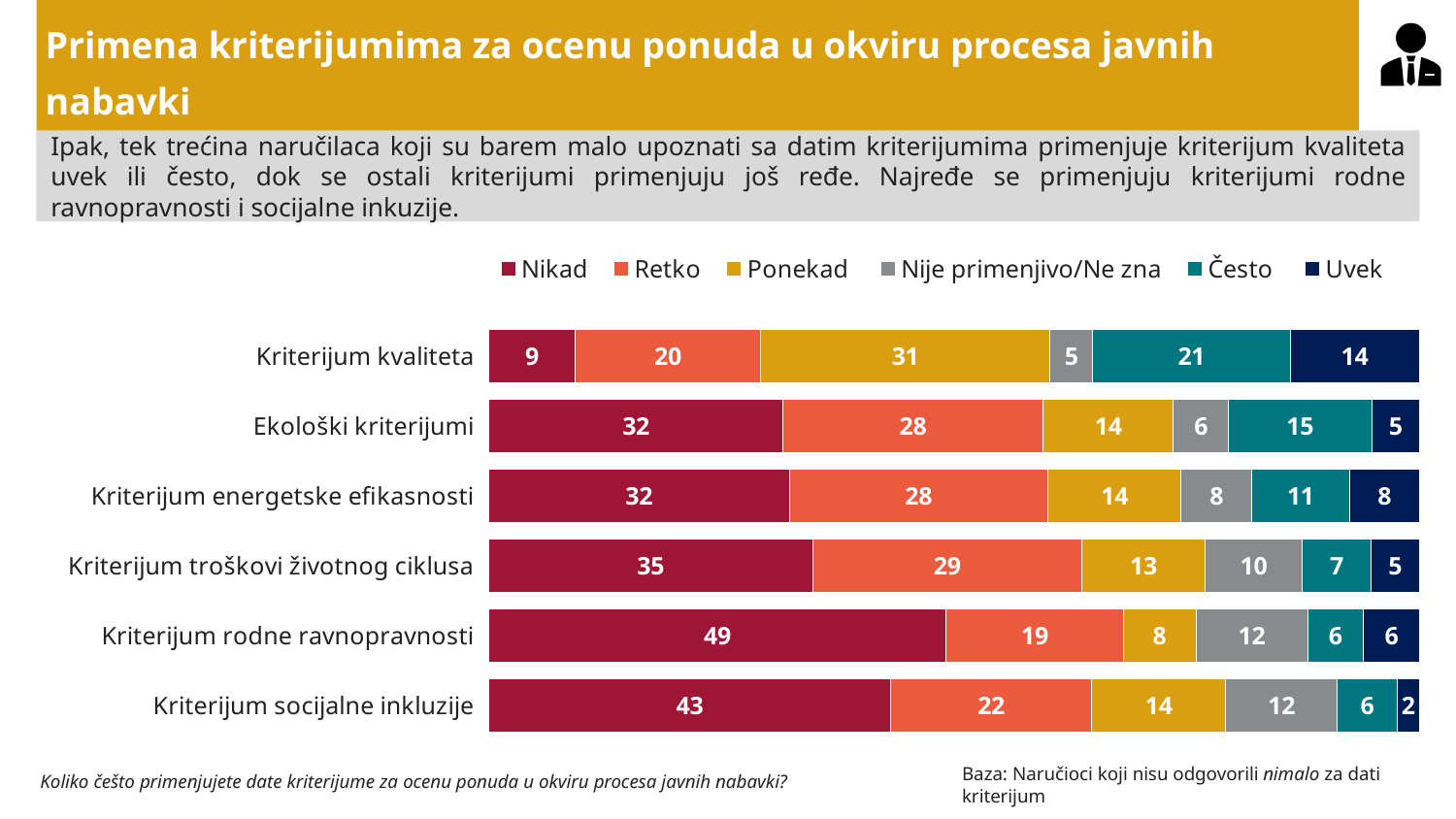
Which category has the highest 'Nikad' value? Kriterijum rodne ravnopravnosti How many series does the legend list? 6 Which legend entry is shown in dark navy blue? Uvek What is the difference between the 'Često' value for Kriterijum kvaliteta and the 'Često' value for Kriterijum troškovi životnog ciklusa? 14 What is the 'Ponekad' value for Kriterijum kvaliteta? 31 Which category has the lowest 'Nikad' value? Kriterijum kvaliteta What is the 'Nikad' value for Kriterijum rodne ravnopravnosti? 49 What is the total of the stacked bar for Kriterijum energetske efikasnosti? 101 What type of chart is shown on the slide? Stacked bar chart What is the 'Uvek' value for Kriterijum socijalne inkluzije? 2 Which is larger: the 'Retko' value for Kriterijum troškovi životnog ciklusa or the 'Retko' value for Kriterijum socijalne inkluzije? Kriterijum troškovi životnog ciklusa How many categories (criteria) are plotted on the chart? 6